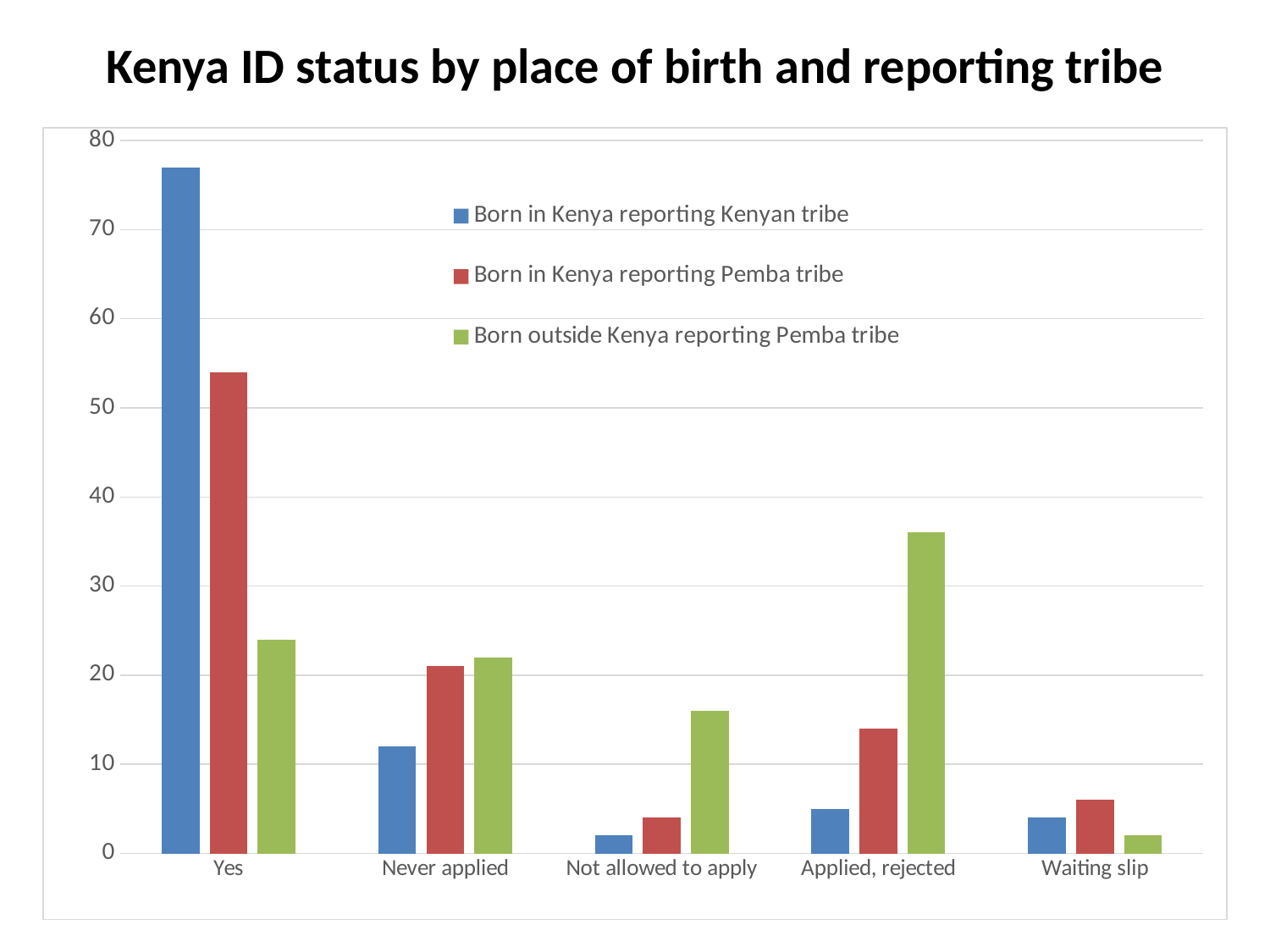
What is the title of the chart? Kenya ID status by place of birth and reporting tribe How many ID status categories are shown on the x axis? 5 Which series has the lowest value in the 'Waiting slip' category? Born outside Kenya reporting Pemba tribe Which series has the lowest value in the 'Yes' category? Born outside Kenya reporting Pemba tribe What kind of chart is shown on the slide? bar chart Is the value for Born in Kenya reporting Kenyan tribe in the 'Yes' category greater or less than 70? greater Is the value for Born outside Kenya reporting Pemba tribe in the 'Not allowed to apply' category greater or less than 20? less How many series does the legend list? 3 Which series has the highest value in the 'Applied, rejected' category? Born outside Kenya reporting Pemba tribe In the 'Yes' category, which is larger: Born in Kenya reporting Kenyan tribe or Born in Kenya reporting Pemba tribe? Born in Kenya reporting Kenyan tribe Which category has the tallest bar in the chart? Yes Is the value for Born outside Kenya reporting Pemba tribe in the 'Applied, rejected' category greater or less than 30? greater